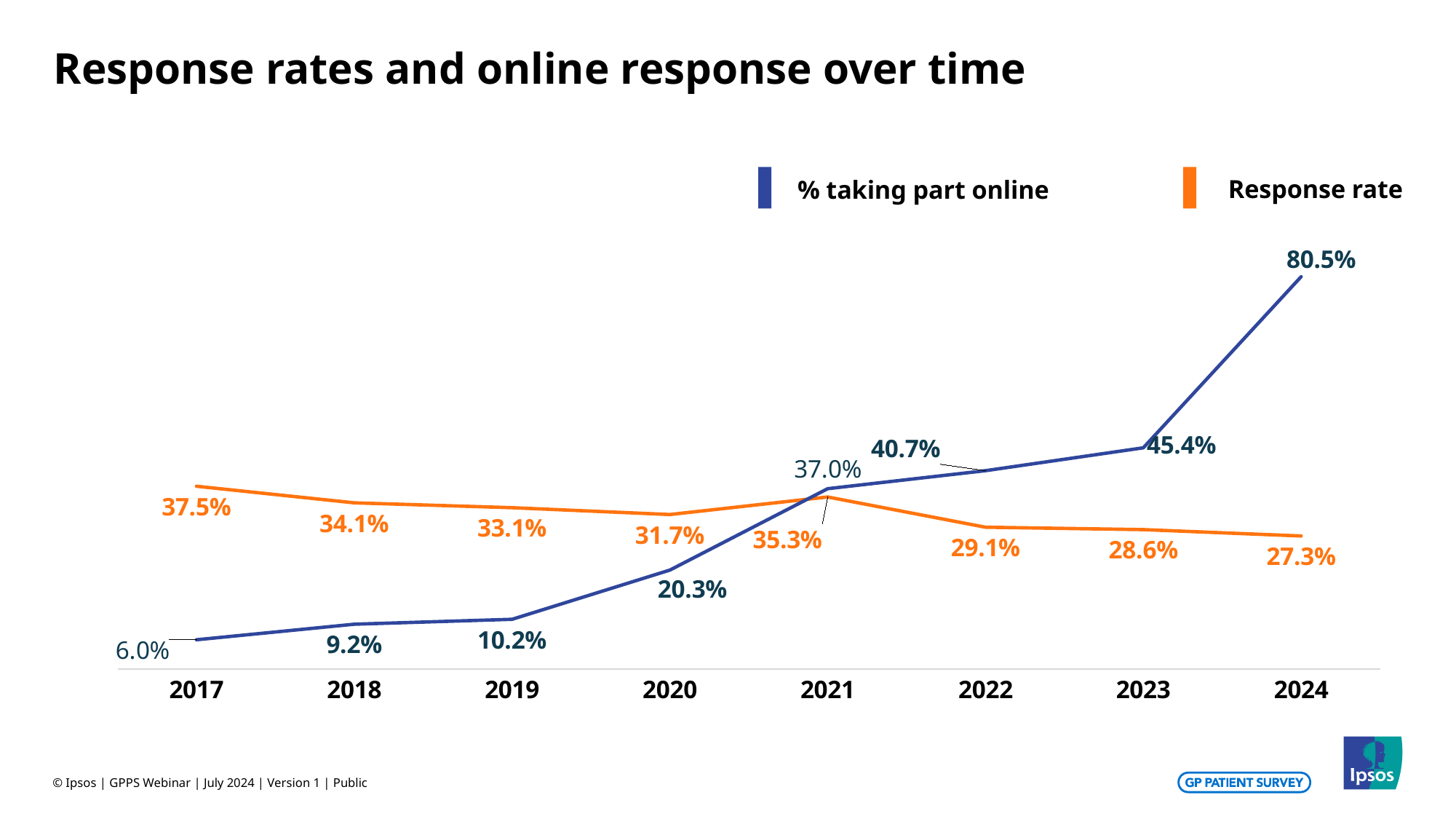
How many series does the legend list? 2 How many years are plotted along the x axis? 8 In which year was the % taking part online lowest? 2017 In which year was the response rate lowest? 2024 What was the response rate in 2021? 35.3% What is the difference between the % taking part online in 2024 and in 2023? 35.1% What type of chart is shown on the slide? line chart What was the % taking part online in 2024? 80.5% What was the % taking part online in 2020? 20.3% What was the response rate in 2017? 37.5% Which was larger in 2019: the response rate or the % taking part online? Response rate Does the response rate generally rise or fall from 2017 to 2024? fall